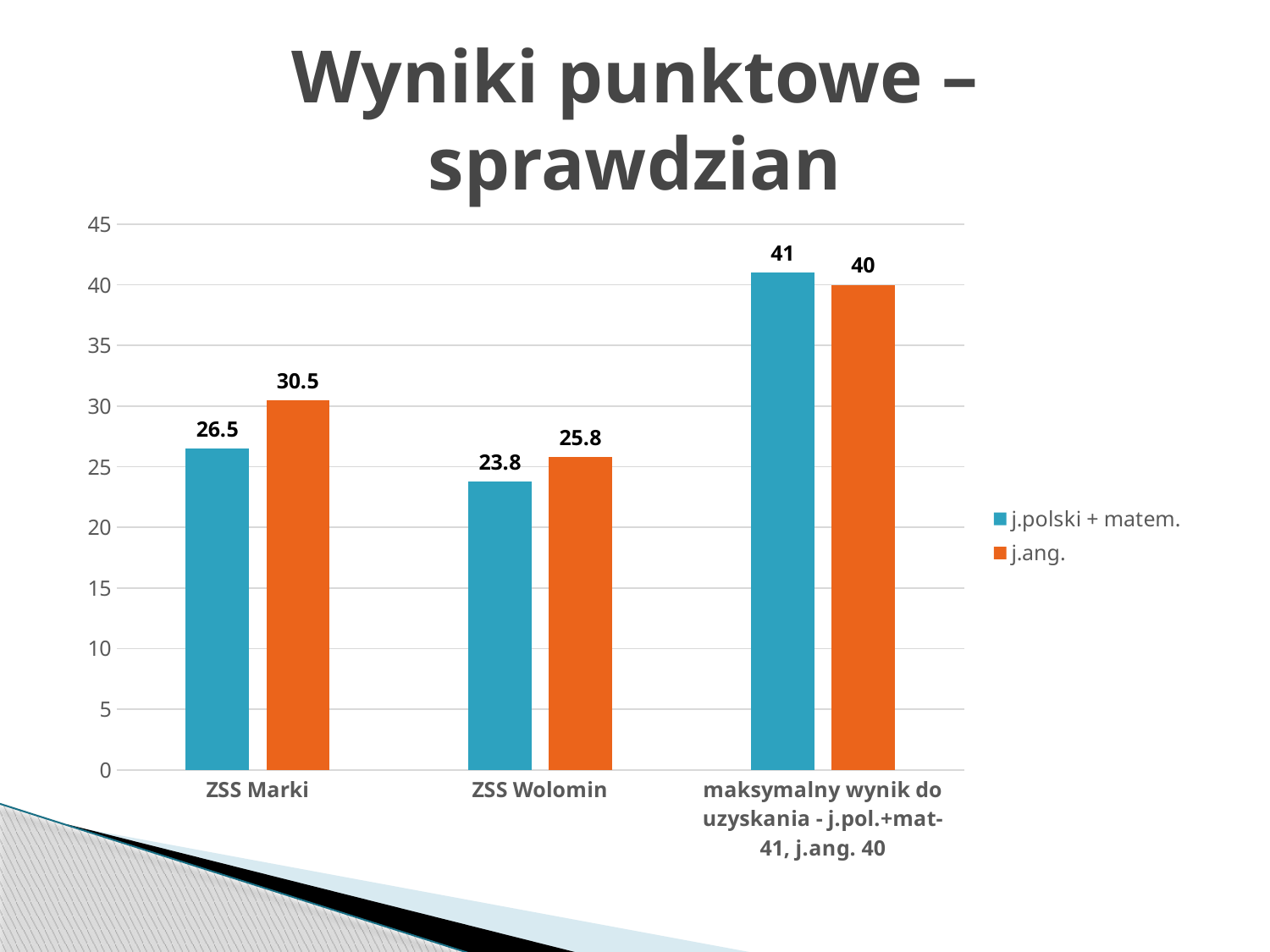
Which category has the lowest j.ang. value? ZSS Wolomin What is the value of j.ang. for ZSS Wolomin? 25.8 Which category has the highest j.polski + matem. value? maksymalny wynik do uzyskania - j.pol.+mat-41, j.ang. 40 How many series does the legend list? 2 What is the difference between the j.polski + matem. values for ZSS Marki and ZSS Wolomin? 2.7 What kind of chart is shown on the slide? bar chart Is the j.polski + matem. value for ZSS Wolomin greater or less than 25? less For ZSS Wolomin, which is larger: j.polski + matem. or j.ang.? j.ang. What is the difference between the j.ang. values for ZSS Marki and ZSS Wolomin? 4.7 What is the value of j.ang. for ZSS Marki? 30.5 What is the value of j.polski + matem. for ZSS Marki? 26.5 How many categories are shown on the x axis? 3